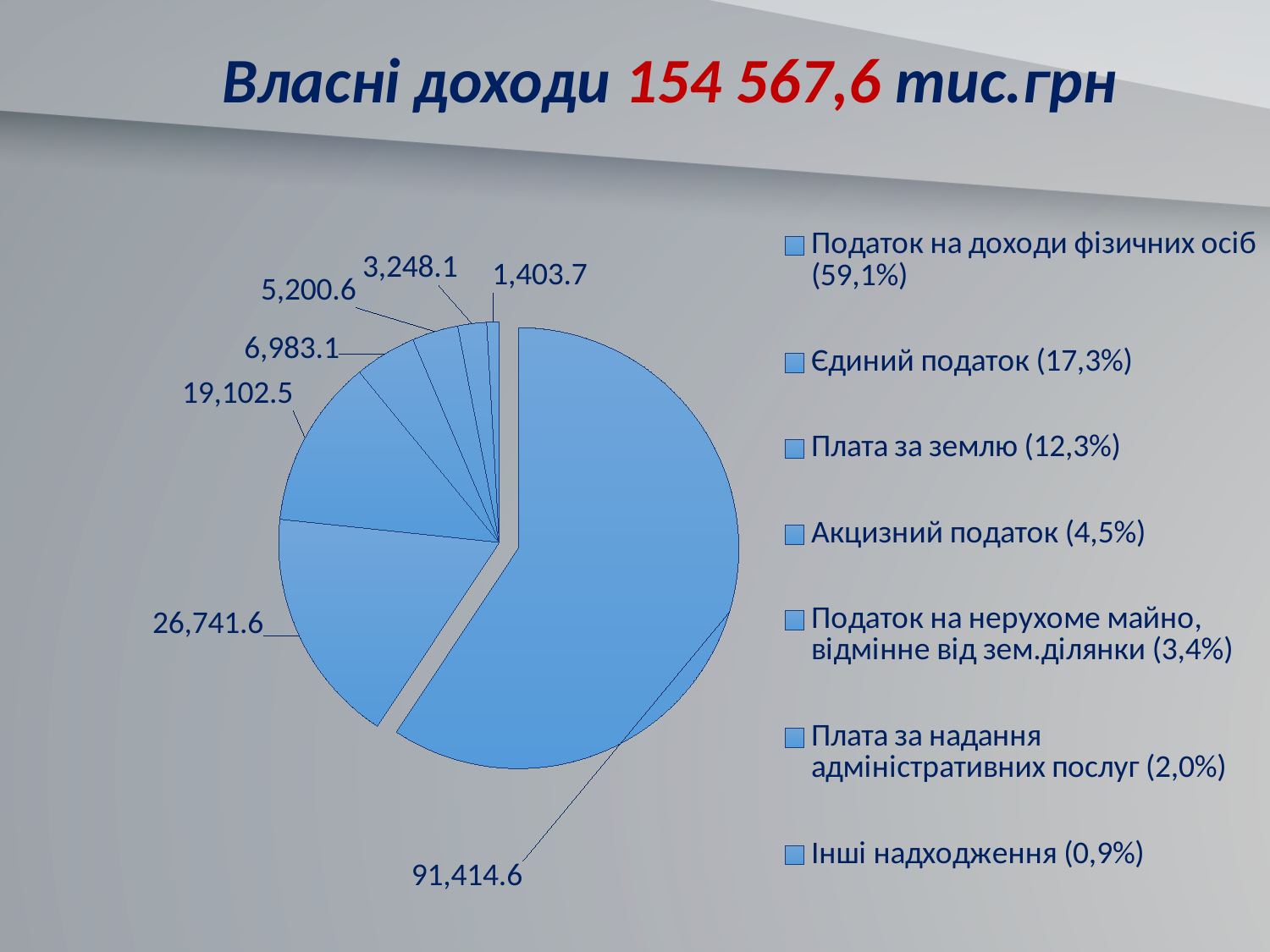
What value is shown for Плата за землю (12,3%)? 19,102.5 What is the difference between the slices labelled 26,741.6 and 19,102.5? 7,639.1 What type of chart is shown on the slide? pie chart Which is larger: the slice for Плата за надання адміністративних послуг or the slice for Інші надходження? Плата за надання адміністративних послуг How many slices does the pie chart have? 7 What value is shown for Єдиний податок (17,3%)? 26,741.6 How many entries does the legend list? 7 What share of the pie does Податок на доходи фізичних осіб represent, according to the legend? 59,1% What is the value of the smallest slice of the pie chart? 1,403.7 What value is shown for Акцизний податок (4,5%)? 6,983.1 What is the value of the largest slice of the pie chart? 91,414.6 What total amount is stated in the slide title? 154 567,6 тис.грн